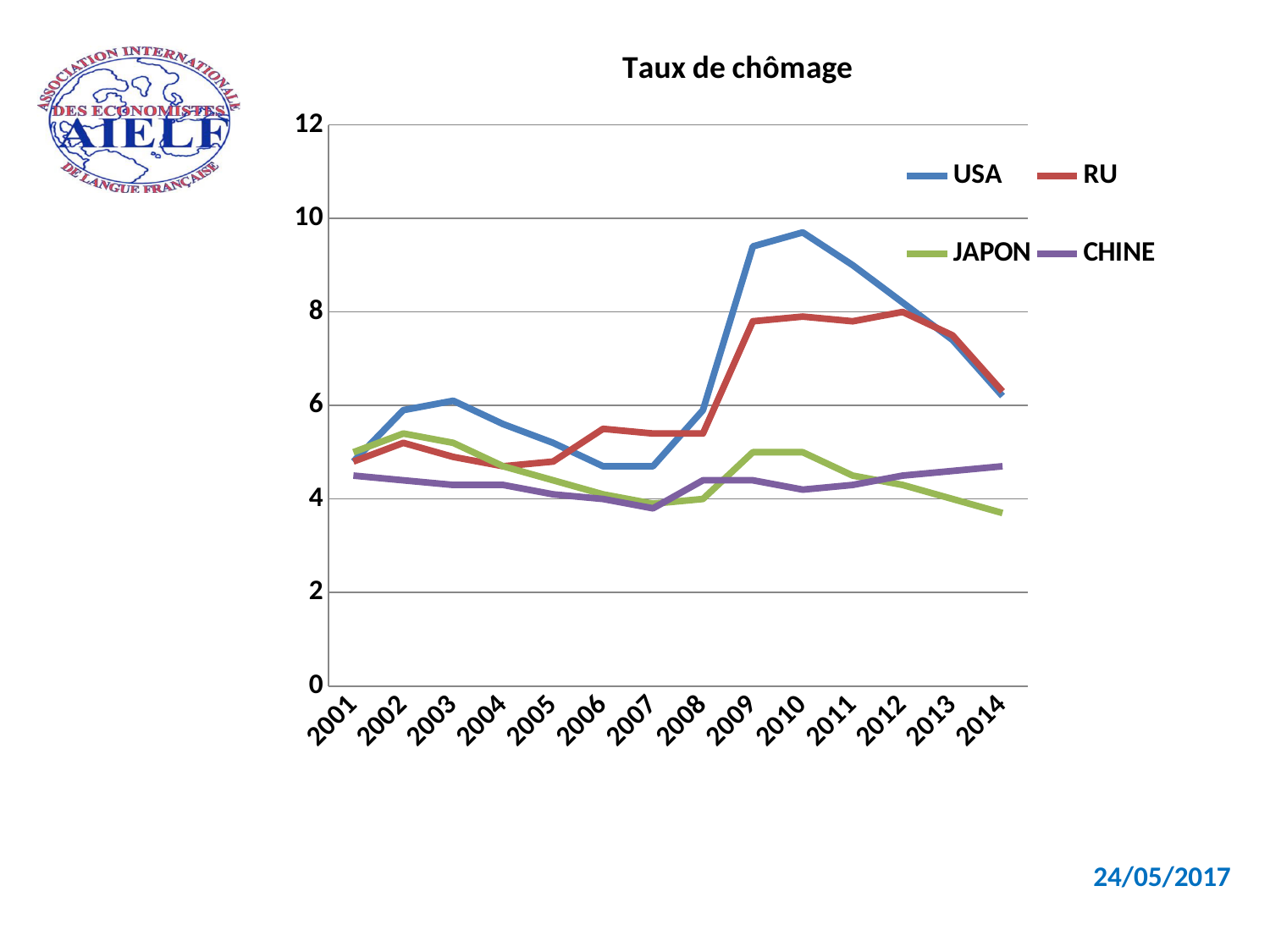
Which series has the lowest unemployment rate in 2014? JAPON Is the value for RU in 2009 greater or less than 6? greater Is the value for JAPON in 2014 greater or less than 4? less What kind of chart is shown on the slide? line chart Which series has the highest unemployment rate in 2010? USA Is the value for USA in 2010 greater or less than 8? greater How many years are shown along the x axis of the chart? 14 In 2014, which is larger: the value for USA or the value for CHINE? USA How many series does the legend of the chart list? 4 What is the title of the chart? Taux de chômage Does the CHINE line rise or fall from 2010 to 2014? rise Does the USA line rise or fall from 2010 to 2014? fall